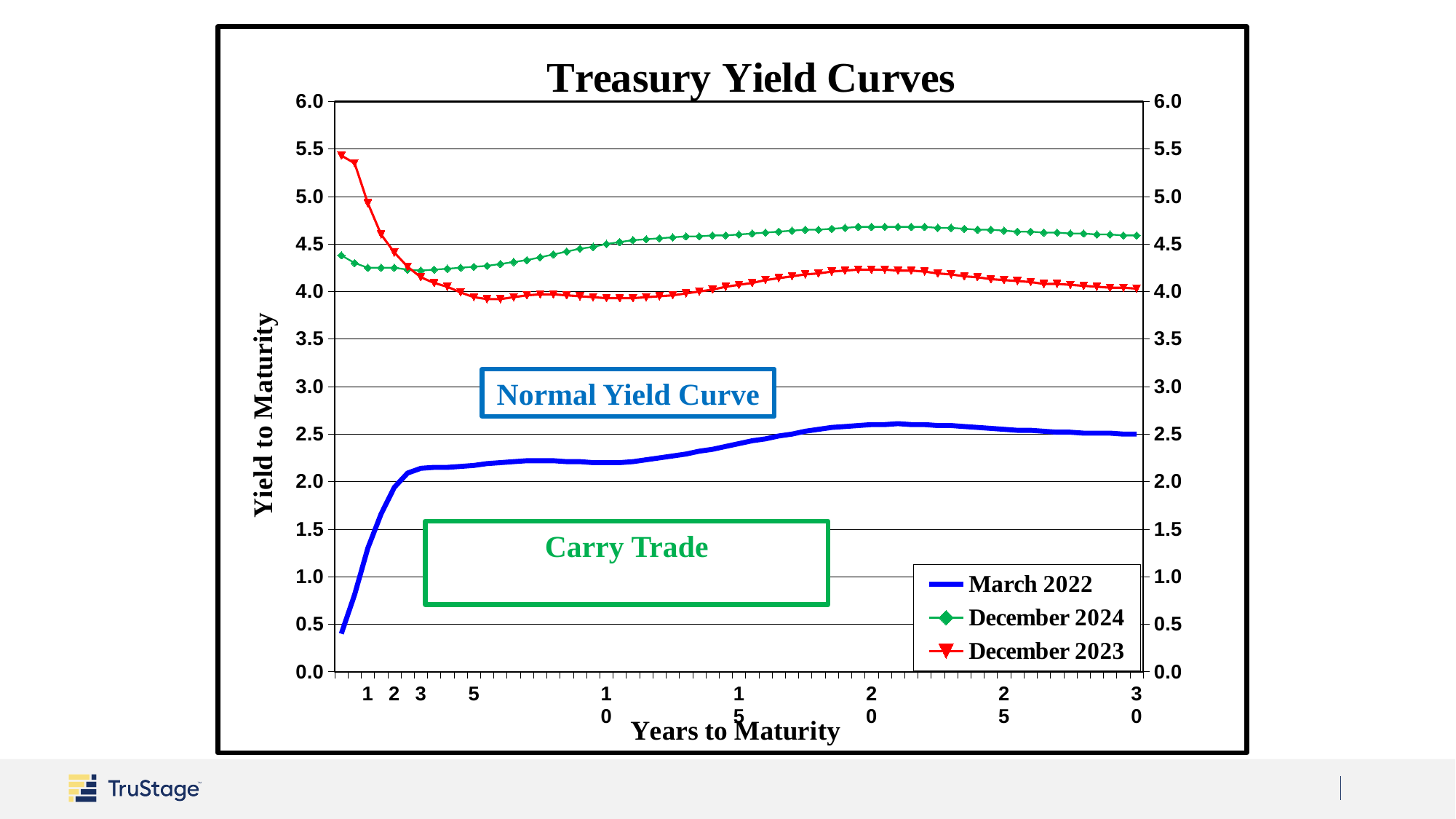
What kind of chart is shown on the slide? line chart At 1 year to maturity, which series has the higher yield: December 2023 or December 2024? December 2023 Is the December 2023 yield at 5 years to maturity greater or less than 4.5? less Does the December 2023 yield rise or fall between 1 and 5 years to maturity? fall Is the December 2024 yield at 30 years to maturity greater or less than 4.0? greater How many series does the legend list? 3 Is the March 2022 yield at 10 years to maturity greater or less than 2.0? greater Which series is drawn as a thick blue line without markers? March 2022 At 30 years to maturity, which series has the higher yield: December 2024 or December 2023? December 2024 Which series has the lowest yields across all maturities? March 2022 What is the title of the chart? Treasury Yield Curves